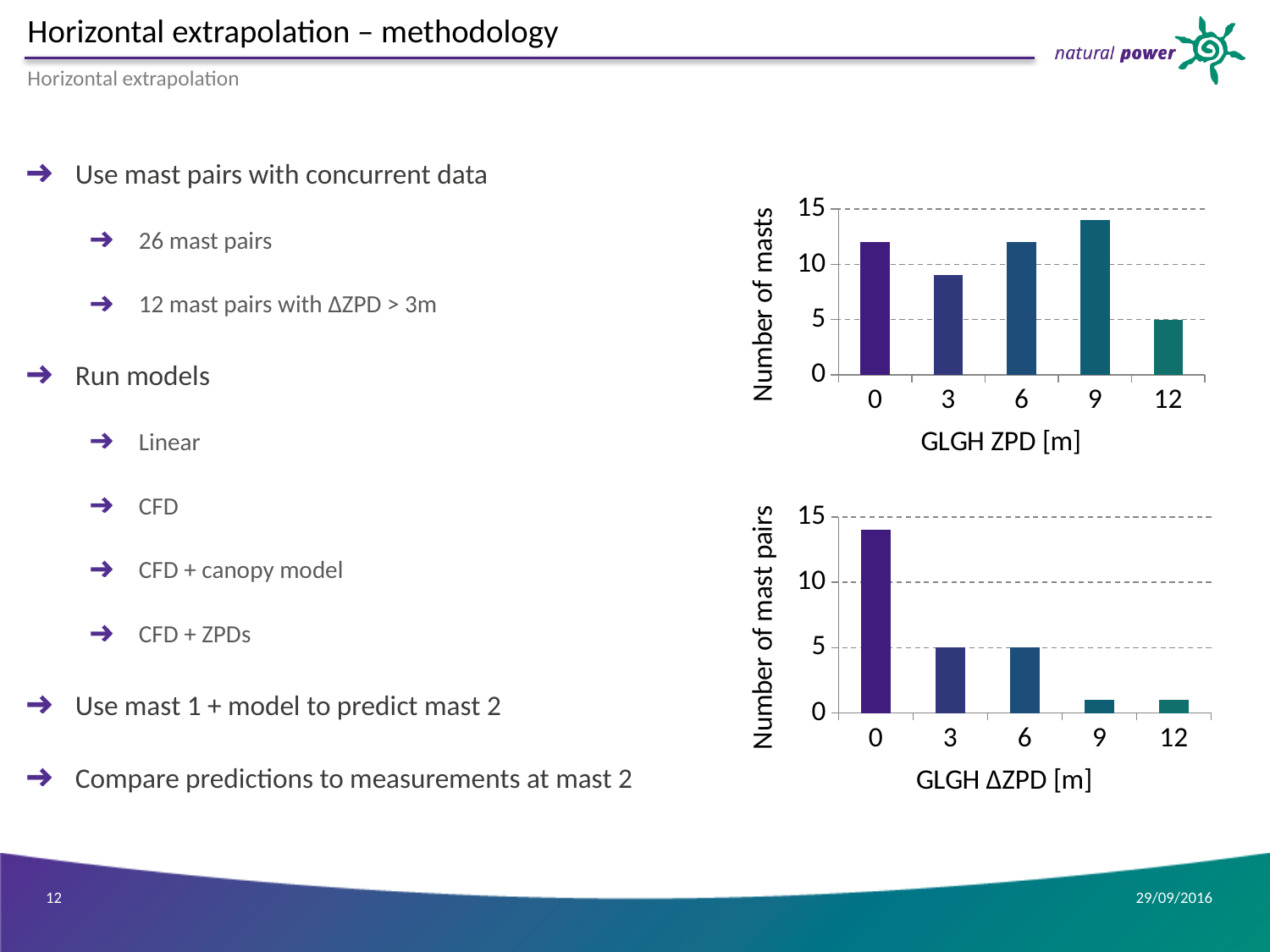
In the bottom chart (Number of mast pairs), which GLGH ΔZPD category has the highest number of mast pairs? 0 In the top chart (Number of masts), which GLGH ZPD category has the lowest number of masts? 12 In the top chart (Number of masts), which GLGH ZPD category has the highest number of masts? 9 In the top chart (Number of masts), which has more masts: GLGH ZPD 0 or GLGH ZPD 3? 0 In the bottom chart (Number of mast pairs), is the value for GLGH ΔZPD 0 greater or less than 10? greater In the bottom chart (Number of mast pairs), is the value for GLGH ΔZPD 9 greater or less than 5? less In the bottom chart (Number of mast pairs), do the values generally rise or fall as GLGH ΔZPD increases from 0 to 12? fall In the top chart (Number of masts), is the value for GLGH ZPD 3 greater or less than 10? less What kind of chart is the top chart on the right, labelled 'Number of masts'? bar chart What is the x-axis label of the bottom chart? GLGH ΔZPD [m] In the top chart (Number of masts), how many bars are plotted? 5